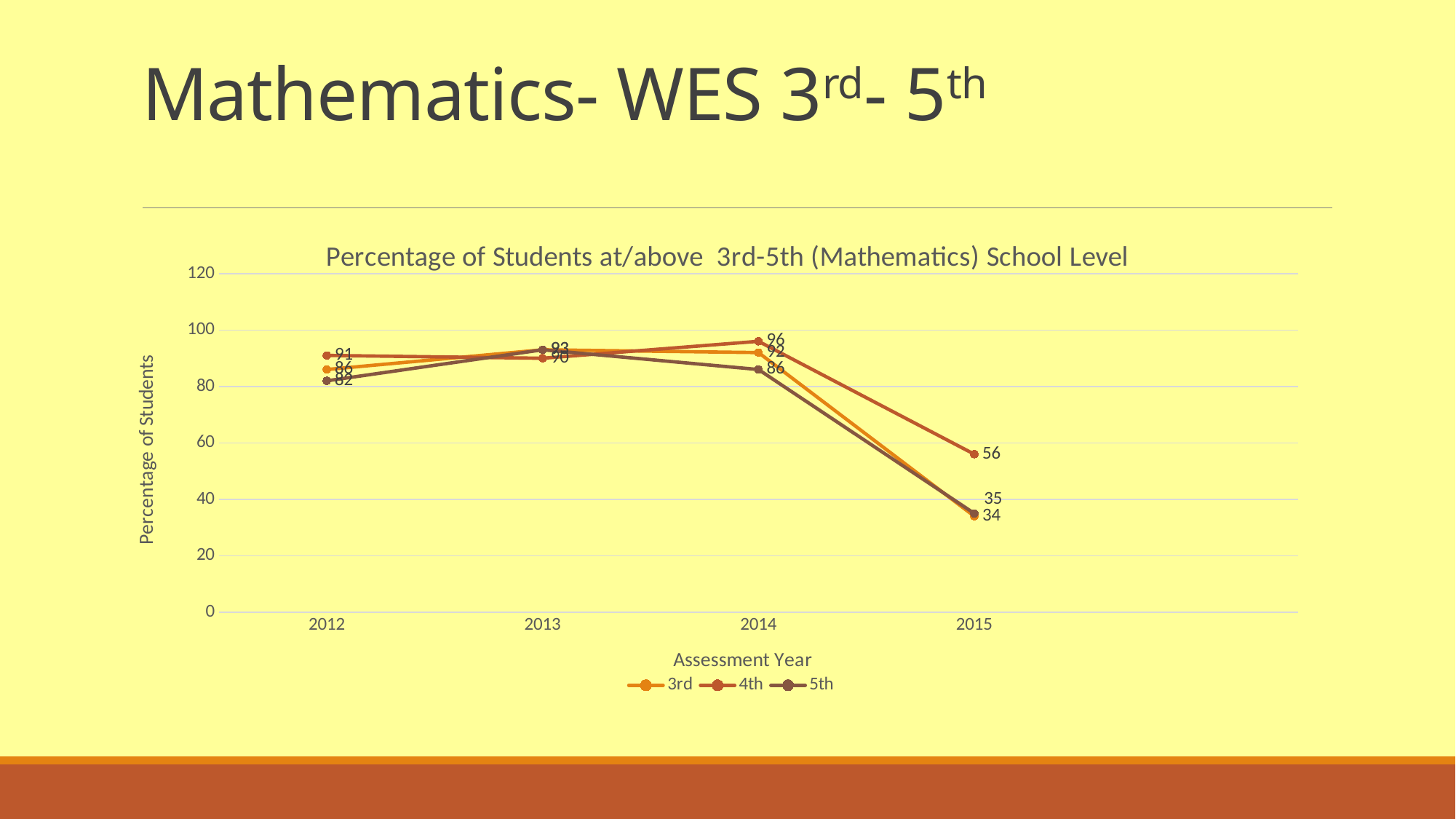
What is the value for the 4th grade series in 2015? 56 In which year does the 4th grade series reach its highest value? 2014 How many assessment years are plotted on the x axis? 4 What is the value for the 5th grade series in 2012? 82 What is the value for the 3rd grade series in 2015? 34 What is the value for the 5th grade series in 2015? 35 In 2015, which series has the larger value, 4th or 5th? 4th How many series does the legend list? 3 What kind of chart is shown on the slide? line chart What is the difference between the 4th grade values in 2014 and 2015? 40 What is the title of the x axis? Assessment Year What is the value for the 4th grade series in 2014? 96